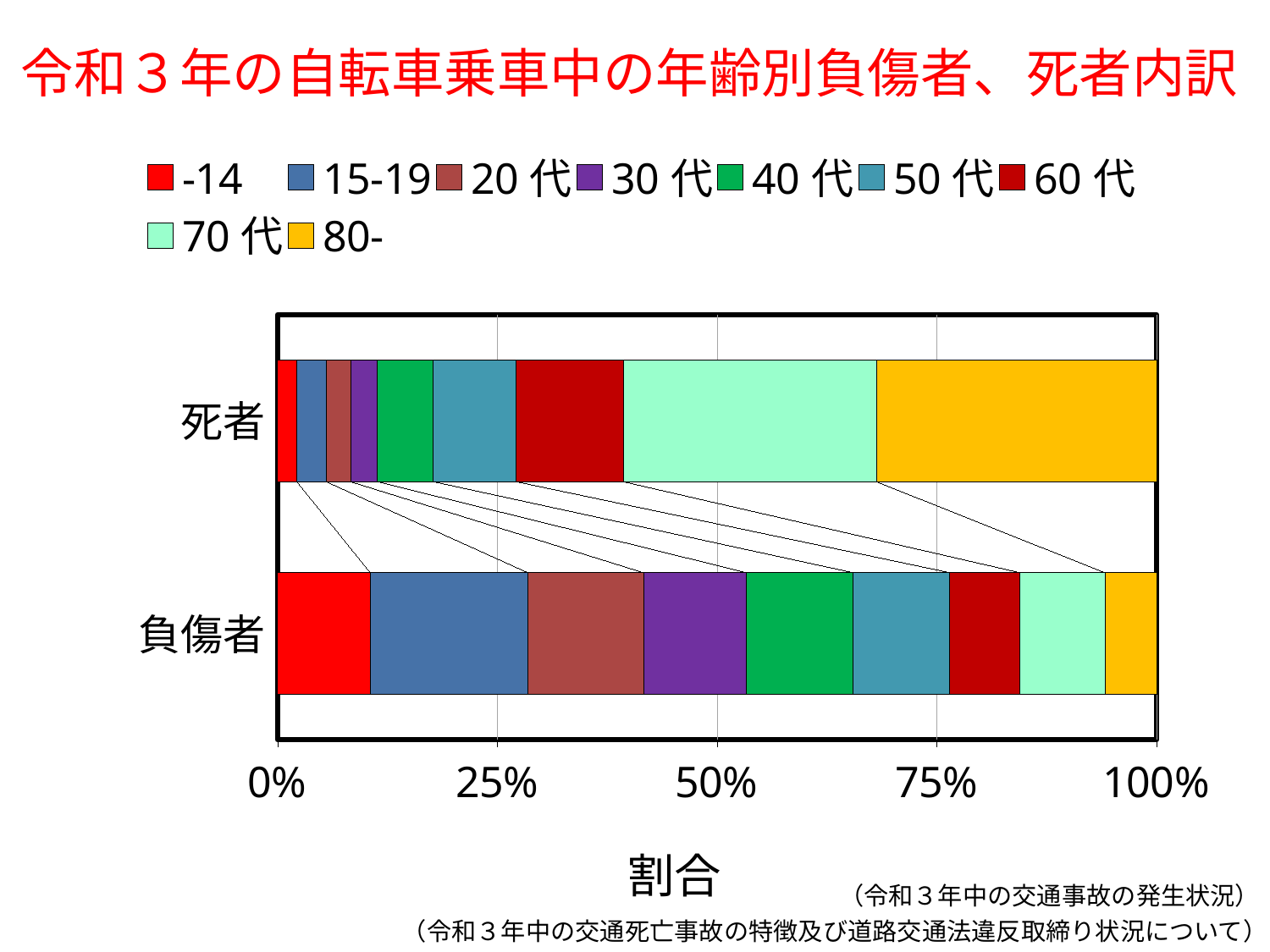
Which age group takes the smallest share of the 負傷者 bar? 80- How many categories (bars) does the chart show? 2 Is the share of 80- in the 死者 bar greater or less than 25%? greater What is the label of the horizontal axis? 割合 Is the share of -14 larger in the 死者 bar or the 負傷者 bar? 負傷者 Which age group takes the largest share of the 死者 bar? 80- Is the share of 80- larger in the 死者 bar or the 負傷者 bar? 死者 What is the title of the chart on the slide? 令和３年の自転車乗車中の年齢別負傷者、死者内訳 Which age group takes the largest share of the 負傷者 bar? 15-19 What kind of chart is shown on the slide? stacked bar chart Is the share of -14 in the 負傷者 bar greater or less than 25%? less How many series does the legend list? 9